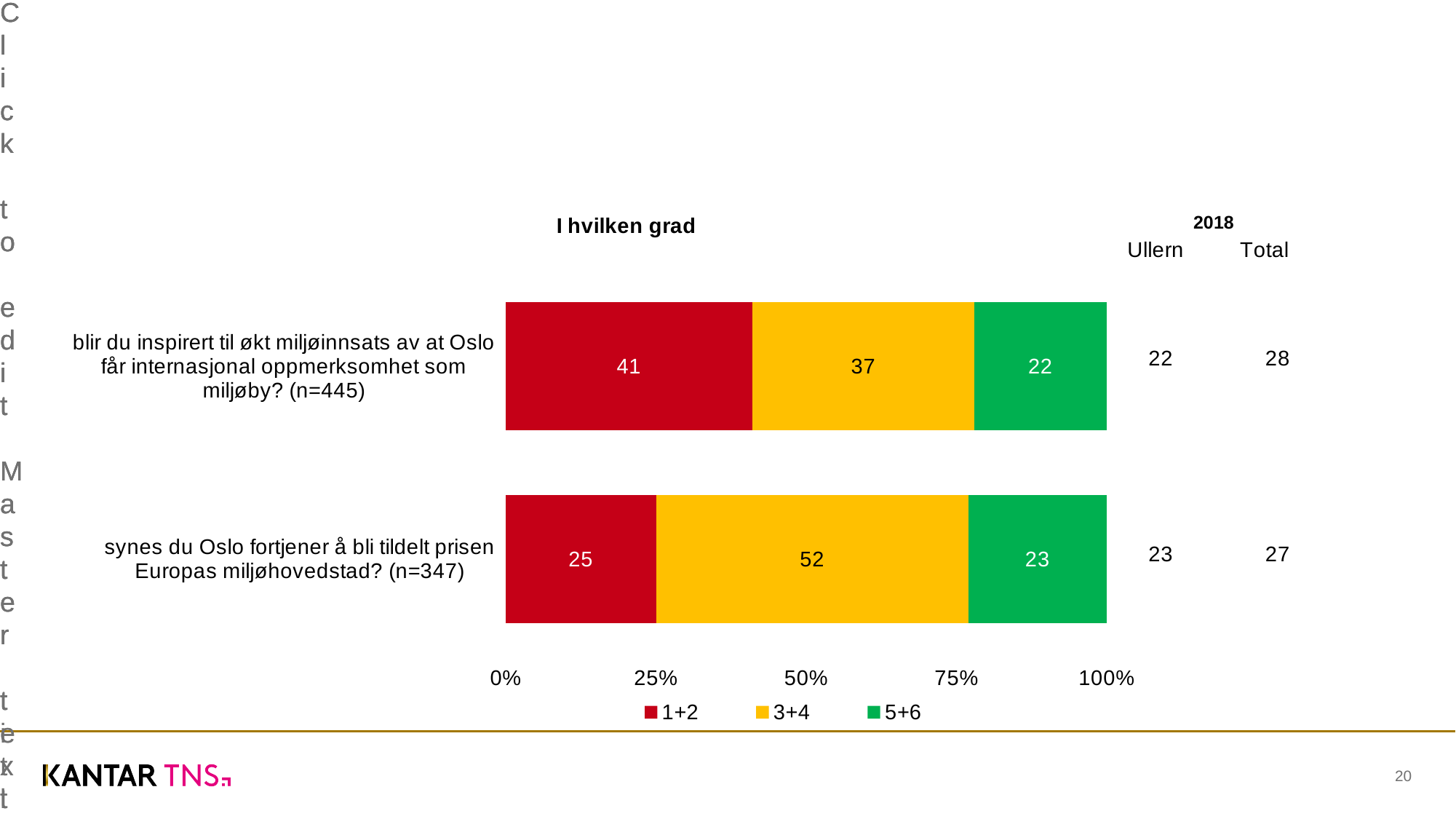
How many series does the legend list? 3 What is the value of the 1+2 series for "blir du inspirert til økt miljøinnsats av at Oslo får internasjonal oppmerksomhet som miljøby? (n=445)"? 41 What is the value of the 3+4 series for "synes du Oslo fortjener å bli tildelt prisen Europas miljøhovedstad? (n=347)"? 52 What is the difference between the 1+2 values of the two questions shown? 16 What is the value of the 1+2 series for "synes du Oslo fortjener å bli tildelt prisen Europas miljøhovedstad? (n=347)"? 25 How many categories (questions) are plotted in the chart? 2 What is the title of the chart? I hvilken grad Which series has the smallest value for "blir du inspirert til økt miljøinnsats av at Oslo får internasjonal oppmerksomhet som miljøby? (n=445)"? 5+6 Which question has the larger 3+4 value? synes du Oslo fortjener å bli tildelt prisen Europas miljøhovedstad? (n=347) Which series has the largest value for "synes du Oslo fortjener å bli tildelt prisen Europas miljøhovedstad? (n=347)"? 3+4 What is the value of the 5+6 series for "blir du inspirert til økt miljøinnsats av at Oslo får internasjonal oppmerksomhet som miljøby? (n=445)"? 22 What kind of chart is shown on the slide? Stacked bar chart